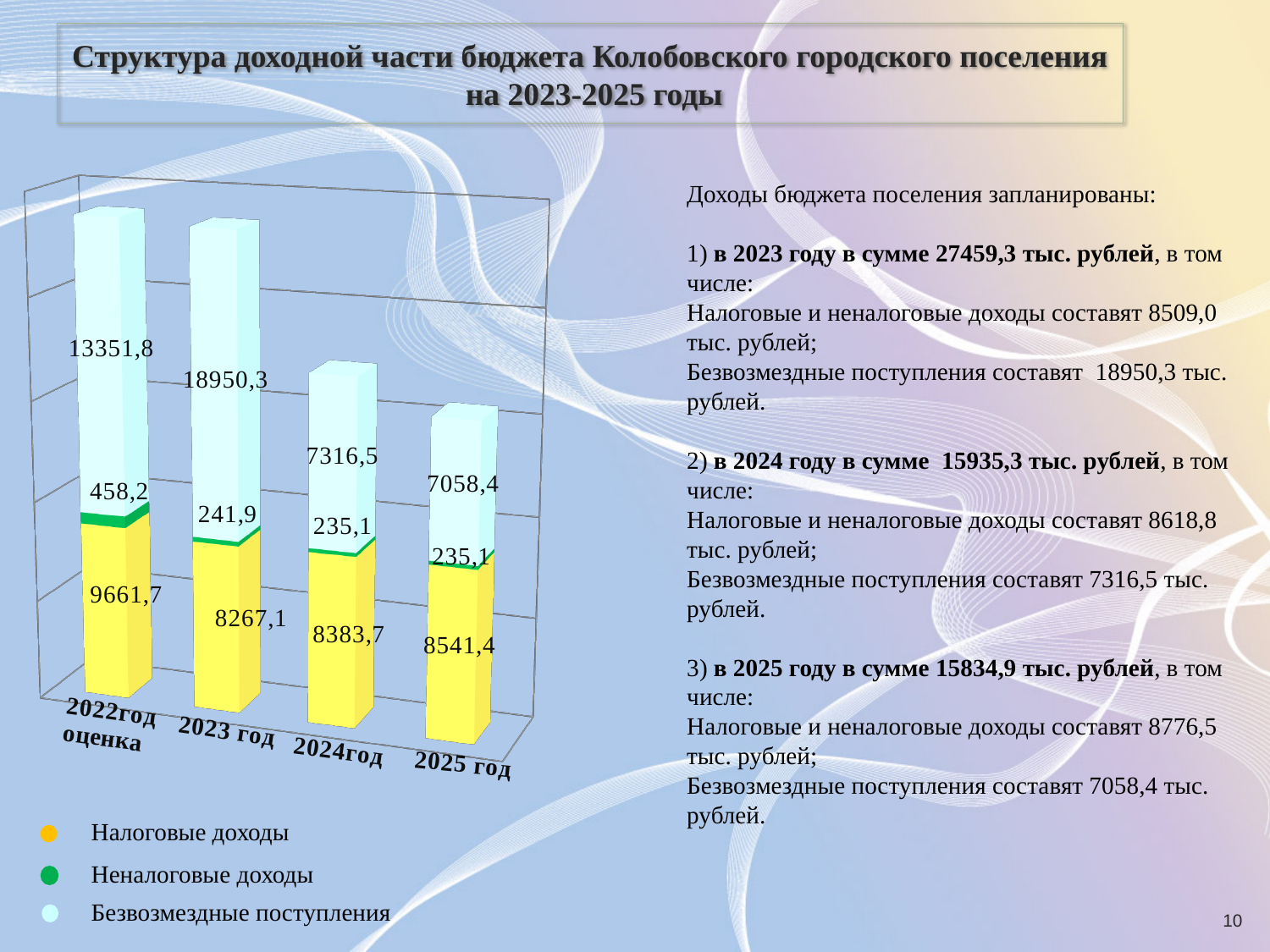
Which is larger: Налоговые доходы in 2024год or in 2025 год? 2025 год What kind of chart is shown on the slide? Stacked bar chart What is the value of Безвозмездные поступления for 2025 год? 7058,4 What is the total of the stacked bar for 2024год? 15935,3 What is the difference between Безвозмездные поступления in 2023 год and 2024год? 11633,8 What is the value of Неналоговые доходы for 2024год? 235,1 What is the value of Безвозмездные поступления for 2023 год? 18950,3 How many series does the legend list? 3 In which year is Налоговые доходы the lowest? 2023 год What is the value of Налоговые доходы for 2022год оценка? 9661,7 How many years (categories) are shown on the chart? 4 In which year is Налоговые доходы the highest? 2022год оценка